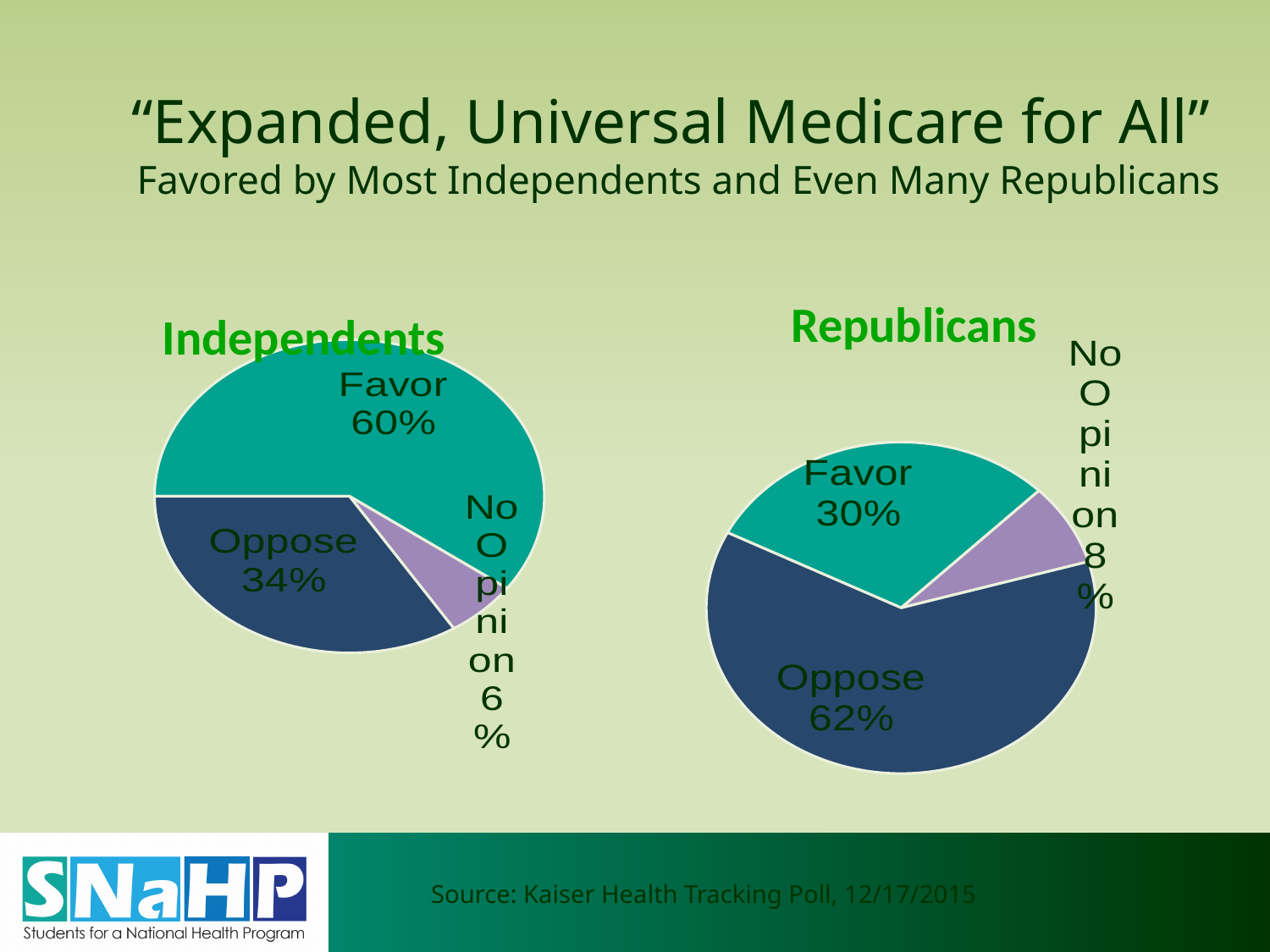
How many slices does the Independents chart have? 3 In the Republicans chart, what is the difference between the Oppose and Favor shares? 32% In the Independents chart, which response has the largest share? Favor In the Republicans chart, what percentage have no opinion? 8% In the Independents chart, what percentage have no opinion? 6% In the Republicans chart, which response has the smallest share? No Opinion In the Independents chart, what percentage favor expanded, universal Medicare for All? 60% In the Republicans chart, what percentage oppose? 62% In the Independents chart, what percentage oppose? 34% Which is larger: the Favor share among Independents or the Favor share among Republicans? Independents What type of chart is the Republicans chart? Pie chart In the Republicans chart, what percentage favor? 30%